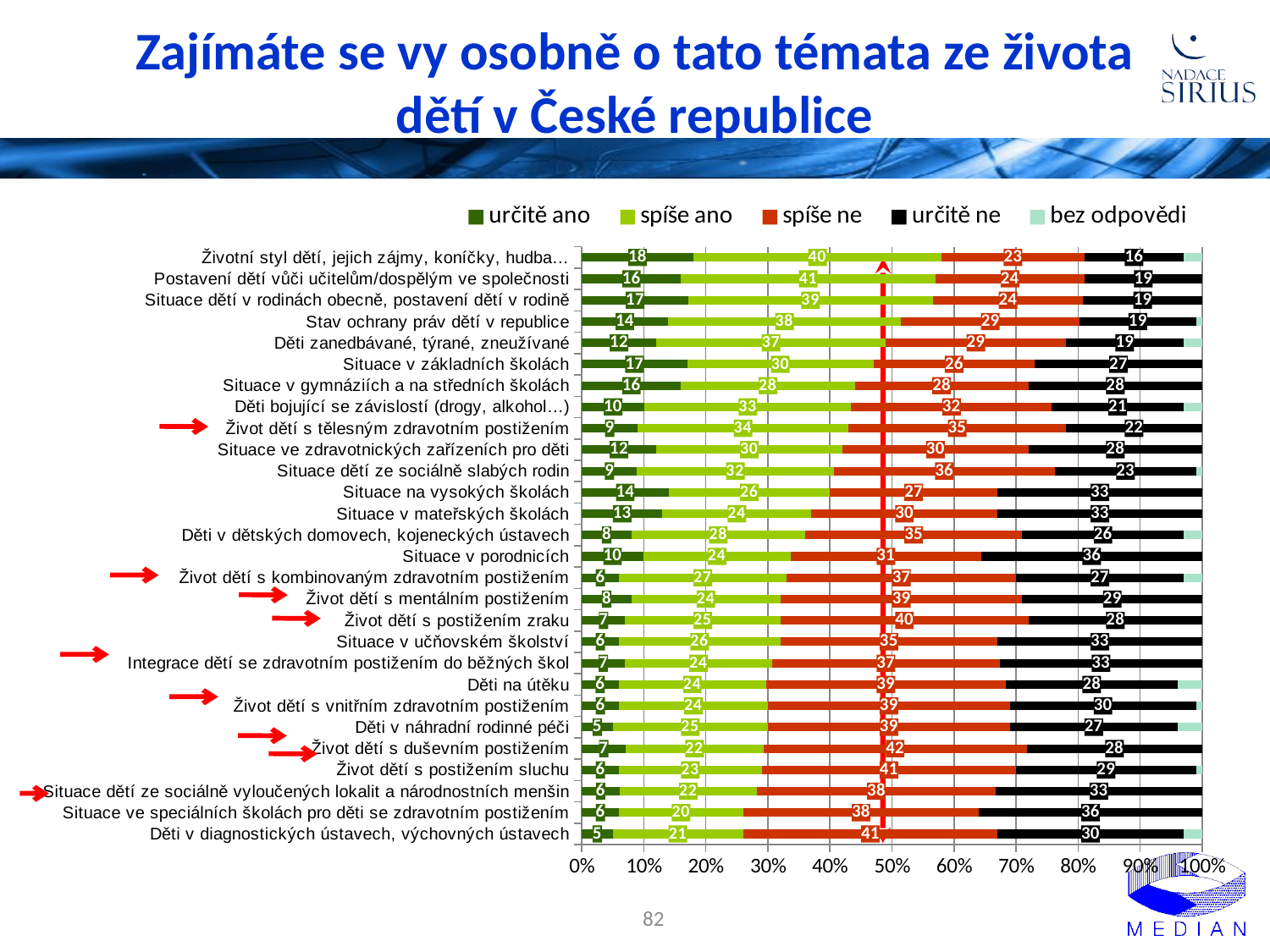
What is the difference between the "spíše ano" values for "Postavení dětí vůči učitelům/dospělým ve společnosti" and "Děti v diagnostických ústavech, výchovných ústavech"? 20 How many categories (topics) are plotted on the chart? 28 Which category has the highest "určitě ano" value? Životní styl dětí, jejich zájmy, koníčky, hudba… Which category has the lowest "spíše ano" value? Situace ve speciálních školách pro děti se zdravotním postižením What is the "určitě ano" value for "Životní styl dětí, jejich zájmy, koníčky, hudba…"? 18 What is the "spíše ne" value for "Život dětí s duševním postižením"? 42 How many series does the legend list? 5 What is the "spíše ano" value for "Stav ochrany práv dětí v republice"? 38 What kind of chart is shown on the slide? bar chart Which is larger: the "určitě ne" value for "Situace na vysokých školách" or for "Situace v základních školách"? Situace na vysokých školách What is the last entry in the chart's legend? bez odpovědi What is the "určitě ne" value for "Situace v porodnicích"? 36